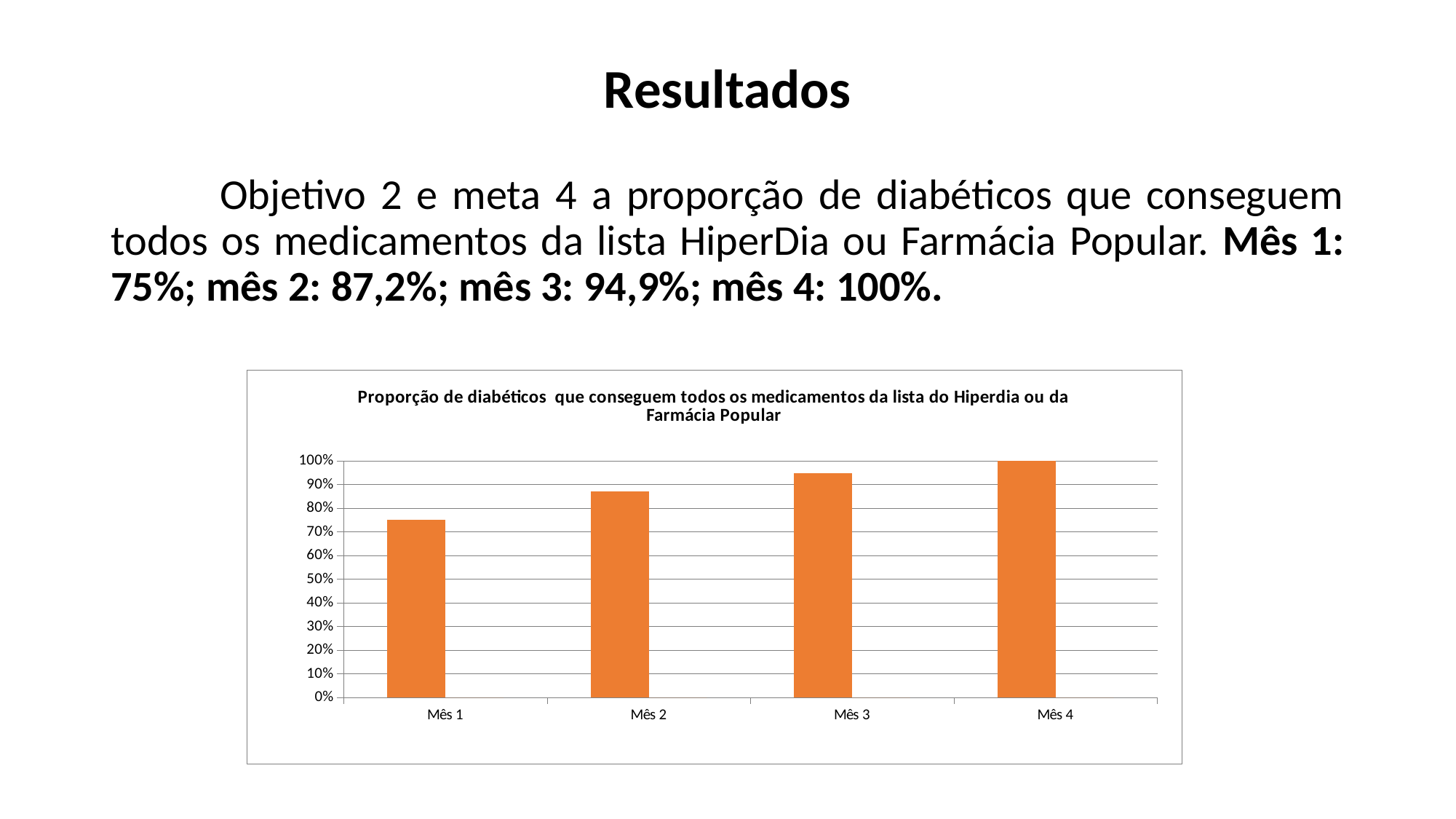
Is the value for Mês 1 greater or less than 80%? less Do the values rise or fall from Mês 1 to Mês 4? rise Which month has the highest proportion in the chart? Mês 4 How many months (categories) are plotted in the chart? 4 Which month has the lowest proportion in the chart? Mês 1 What is the proportion for Mês 4? 100% What is the proportion for Mês 2? 87,2% What is the proportion for Mês 1? 75% What kind of chart is shown on the slide? bar chart What is the proportion for Mês 3? 94,9% Is the value for Mês 2 greater or less than 80%? greater What is the difference between the proportions for Mês 4 and Mês 1? 25%